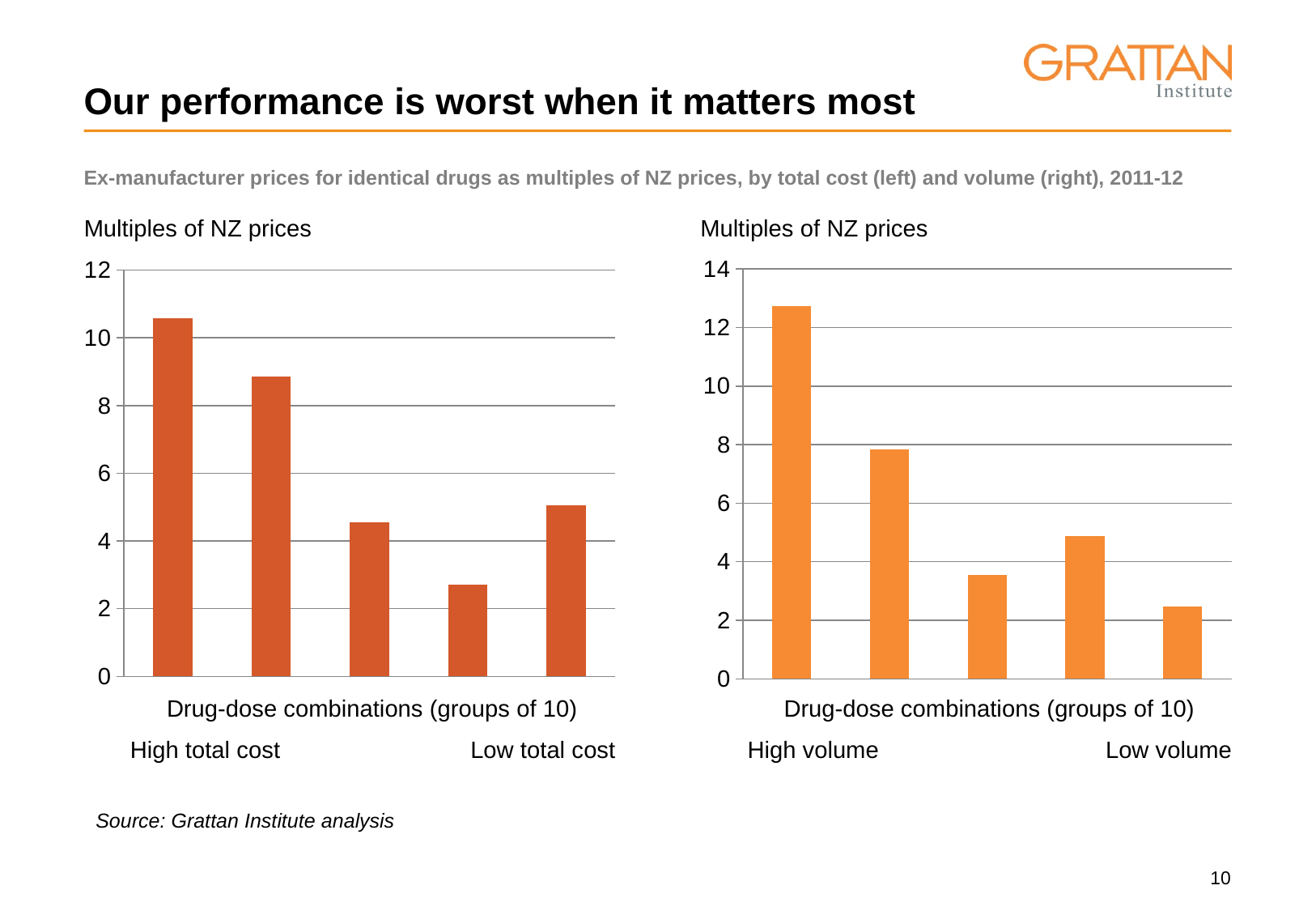
In the left chart (by total cost), is the value for the High total cost bar greater or less than 10? greater In the left chart (by total cost), which bar is the highest? the first bar (High total cost) In the right chart (by volume), which bar is the highest? the first bar (High volume) In the right chart (by volume), is the value for the Low volume bar greater or less than 4? less In the left chart (by total cost), which is larger: the High total cost bar or the Low total cost bar? High total cost What kind of chart is the left chart (by total cost)? bar chart In the right chart (by volume), is the value for the High volume bar greater or less than 12? greater How many bars are plotted in the right chart (by volume)? 5 In the left chart (by total cost), which bar is the lowest? the fourth bar In the right chart (by volume), which bar is the lowest? the last bar (Low volume) In the right chart (by volume), which is larger: the third bar or the fourth bar? the fourth bar What is the y-axis label shown above each chart? Multiples of NZ prices